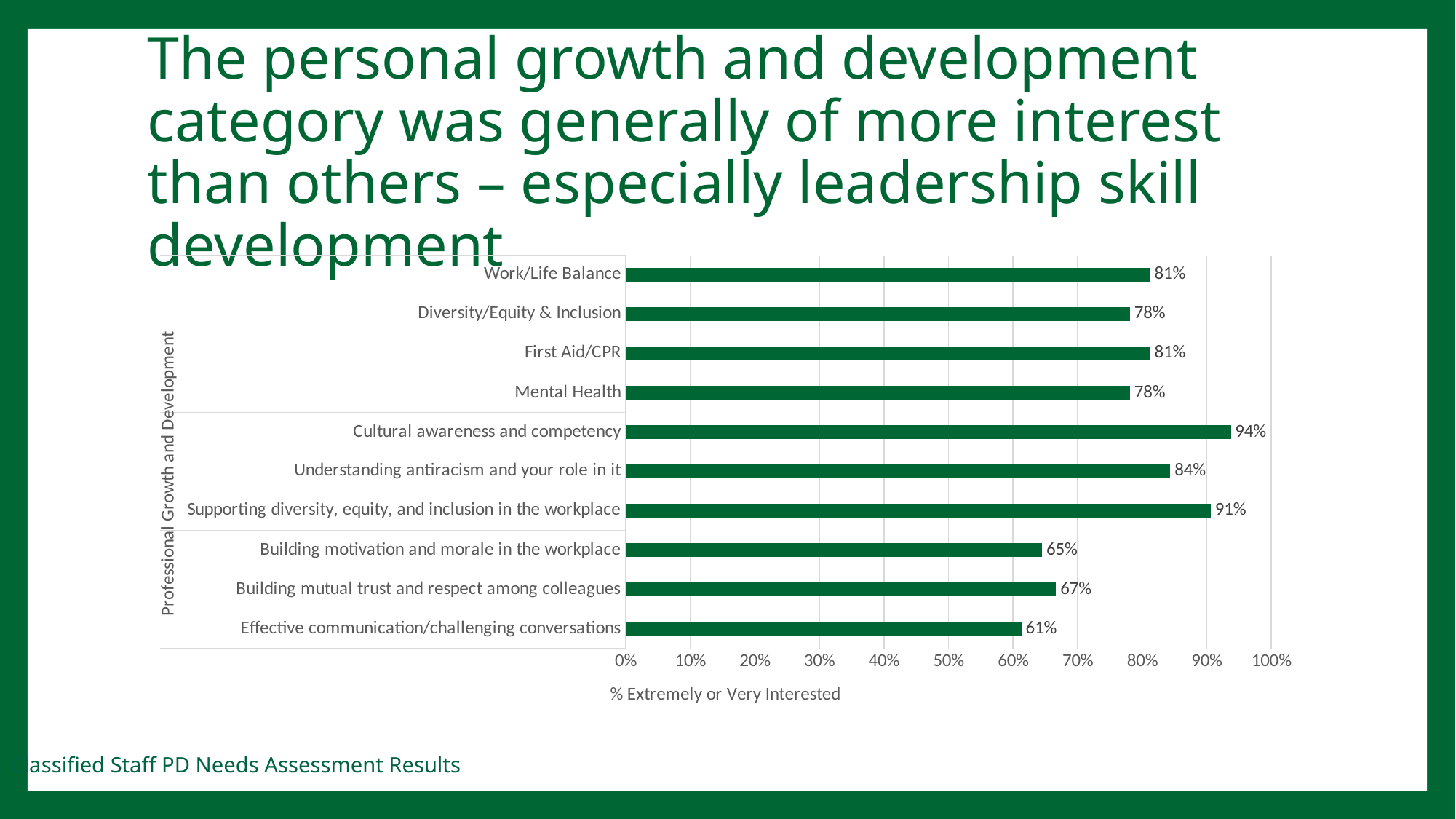
Which category has the highest value? Cultural awareness and competency What is the value for Cultural awareness and competency? 94% What is the value for Building mutual trust and respect among colleagues? 67% What kind of chart is shown on the slide? Bar chart What is the difference between the values for Cultural awareness and competency and Supporting diversity, equity, and inclusion in the workplace? 3% What is the label of the horizontal axis? % Extremely or Very Interested How many categories are shown in the chart? 10 What is the value for Effective communication/challenging conversations? 61% What is the difference between the values for Work/Life Balance and Building motivation and morale in the workplace? 16% Which category has the lowest value? Effective communication/challenging conversations What is the value for Understanding antiracism and your role in it? 84% Which is larger, the value for Mental Health or the value for Building mutual trust and respect among colleagues? Mental Health